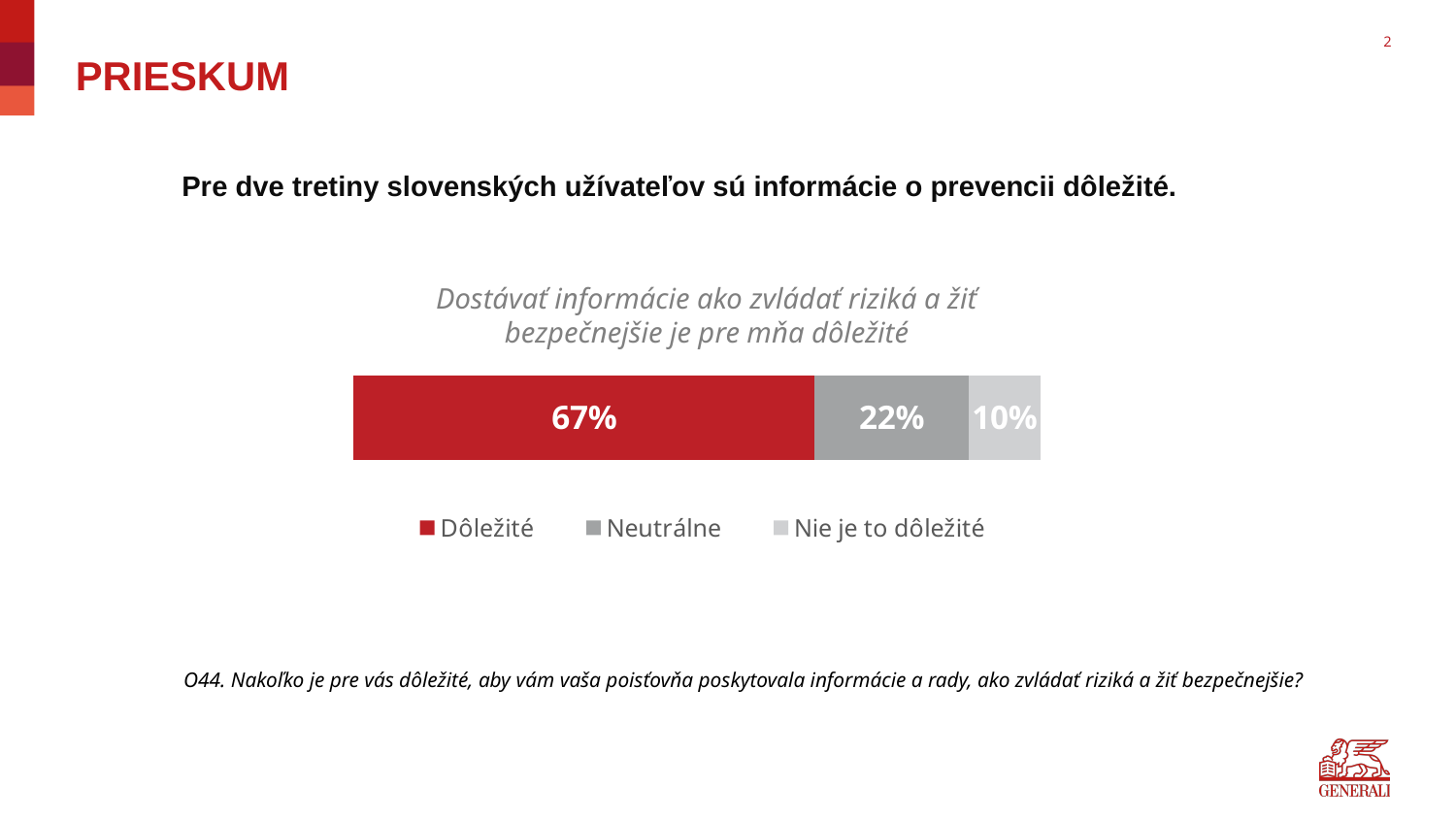
Which is larger, the share for "Neutrálne" or for "Nie je to dôležité"? Neutrálne Which colour represents "Dôležité" in the chart? Red What percentage of respondents answered "Nie je to dôležité"? 10% What kind of chart is shown on the slide? Stacked bar chart What percentage of respondents answered "Dôležité"? 67% What is the difference in percentage points between "Neutrálne" and "Nie je to dôležité"? 12 What percentage of respondents answered "Neutrálne"? 22% What is the difference in percentage points between "Dôležité" and "Neutrálne"? 45 Which response category has the smallest share? Nie je to dôležité How many series does the legend list? 3 Which response category has the largest share? Dôležité What is the title of the chart? Dostávať informácie ako zvládať riziká a žiť bezpečnejšie je pre mňa dôležité